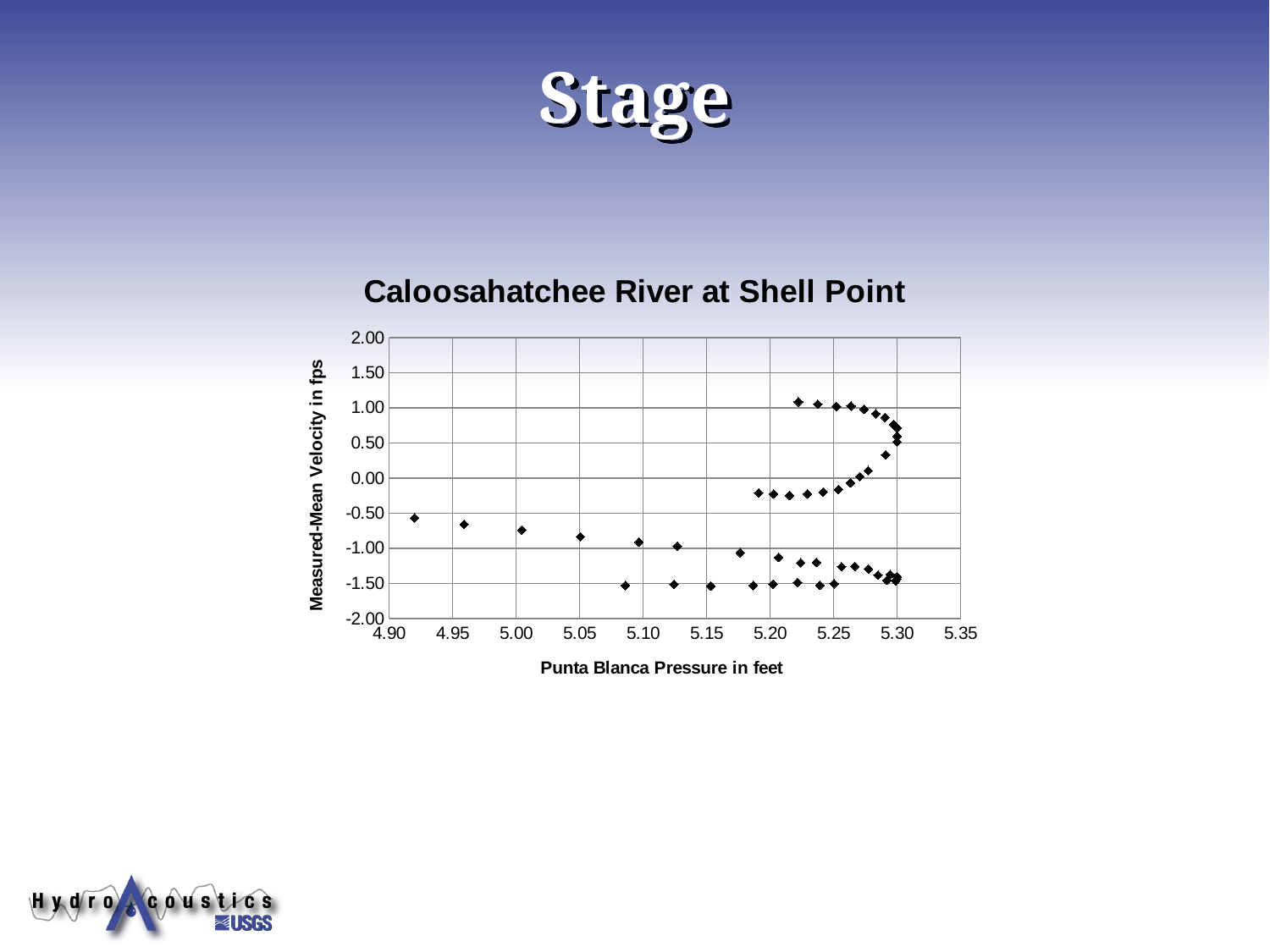
What is the label of the x axis of the chart? Punta Blanca Pressure in feet Is the leftmost plotted point's velocity greater or less than -1.00 fps? greater Is the leftmost plotted point's pressure greater or less than 4.95 feet? less Is the highest plotted velocity value greater or less than 1.50 fps? less What is the title of the chart? Caloosahatchee River at Shell Point What kind of chart is shown on the slide? Scatter plot